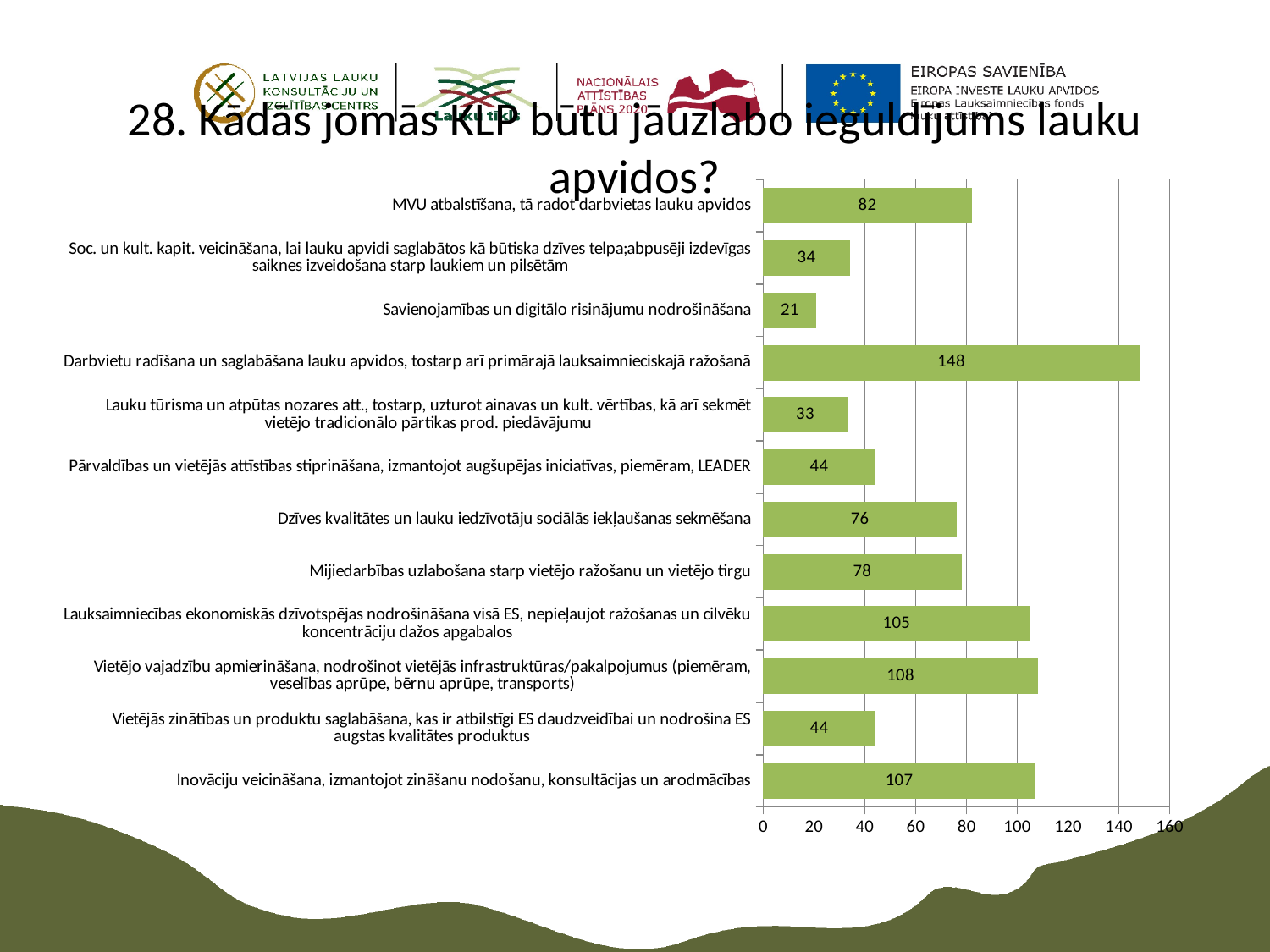
What is the maximum value shown on the horizontal axis of the chart? 160 What is the value for "Savienojamības un digitālo risinājumu nodrošināšana"? 21 What is the difference between the value for "Darbvietu radīšana un saglabāšana lauku apvidos..." (148) and "MVU atbalstīšana, tā radot darbvietas lauku apvidos" (82)? 66 How many categories are plotted in the chart? 12 What is the value for "Lauku tūrisma un atpūtas nozares att., tostarp, uzturot ainavas un kult. vērtības..."? 33 Which is larger: the value for "Mijiedarbības uzlabošana starp vietējo ražošanu un vietējo tirgu" or the value for "Pārvaldības un vietējās attīstības stiprināšana, izmantojot augšupējas iniciatīvas, piemēram, LEADER"? Mijiedarbības uzlabošana starp vietējo ražošanu un vietējo tirgu What is the value for "Inovāciju veicināšana, izmantojot zināšanu nodošanu, konsultācijas un arodmācības"? 107 Which category has the lowest value? Savienojamības un digitālo risinājumu nodrošināšana What is the value for "Dzīves kvalitātes un lauku iedzīvotāju sociālās iekļaušanas sekmēšana"? 76 Is the value for "Vietējo vajadzību apmierināšana, nodrošinot vietējās infrastruktūras/pakalpojumus" greater or less than 100? greater Which category has the highest value? Darbvietu radīšana un saglabāšana lauku apvidos, tostarp arī primārajā lauksaimnieciskajā ražošanā What type of chart is shown on the slide? bar chart